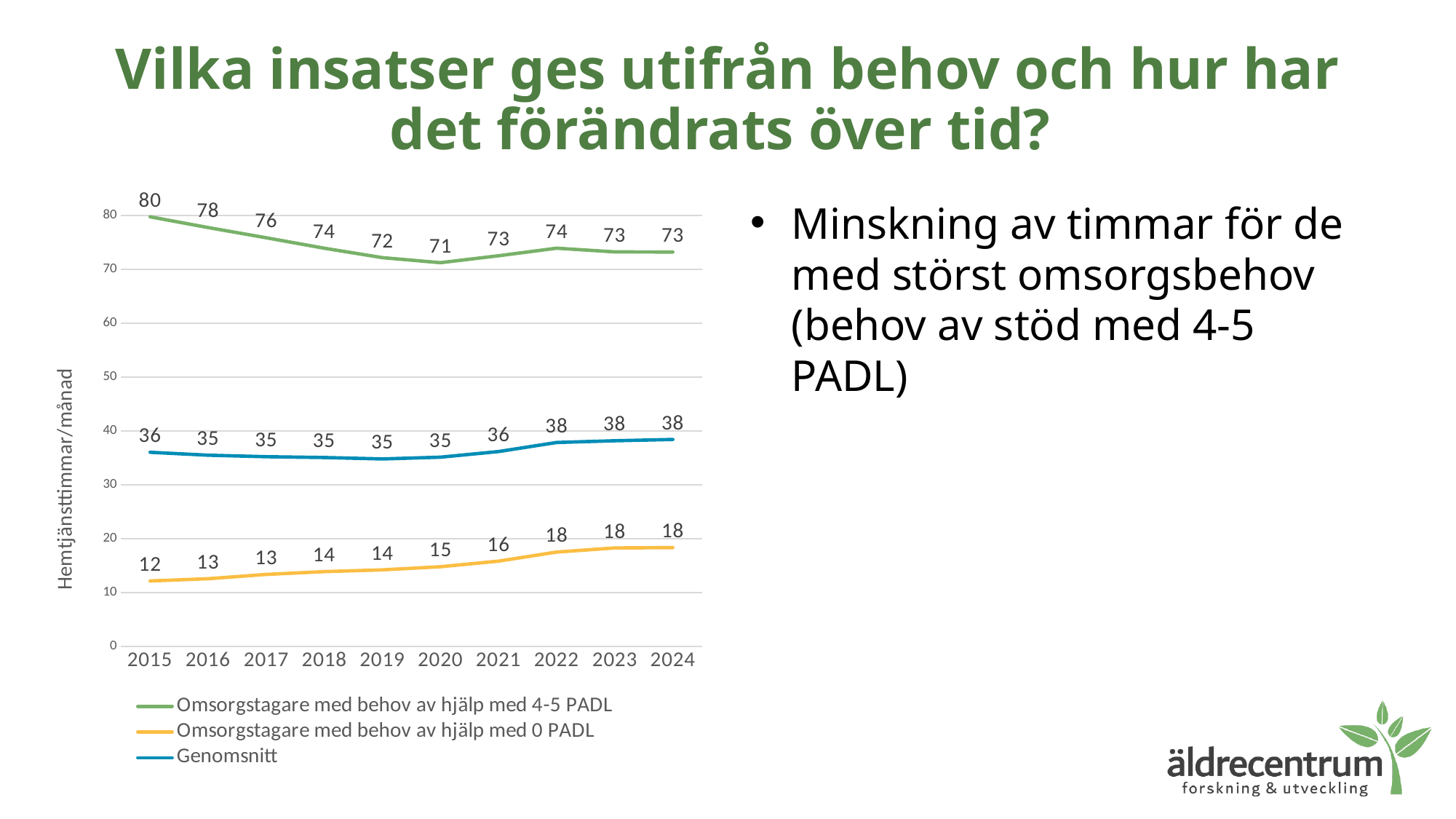
In which year is the value for 'Omsorgstagare med behov av hjälp med 4-5 PADL' lowest? 2020 What is the value for 'Omsorgstagare med behov av hjälp med 4-5 PADL' in 2015? 80 Do the values for 'Omsorgstagare med behov av hjälp med 0 PADL' rise or fall from 2015 to 2024? rise What is the difference between the 2015 and 2024 values for 'Omsorgstagare med behov av hjälp med 4-5 PADL'? 7 What type of chart is shown on the slide? line chart What is the label of the y axis? Hemtjänsttimmar/månad What is the value for 'Omsorgstagare med behov av hjälp med 0 PADL' in 2020? 15 How many years are shown on the x axis? 10 What is the value for 'Genomsnitt' in 2024? 38 In which year is the value for 'Omsorgstagare med behov av hjälp med 0 PADL' lowest? 2015 How many series does the legend list? 3 Which series has the higher value in 2022: 'Genomsnitt' or 'Omsorgstagare med behov av hjälp med 0 PADL'? Genomsnitt